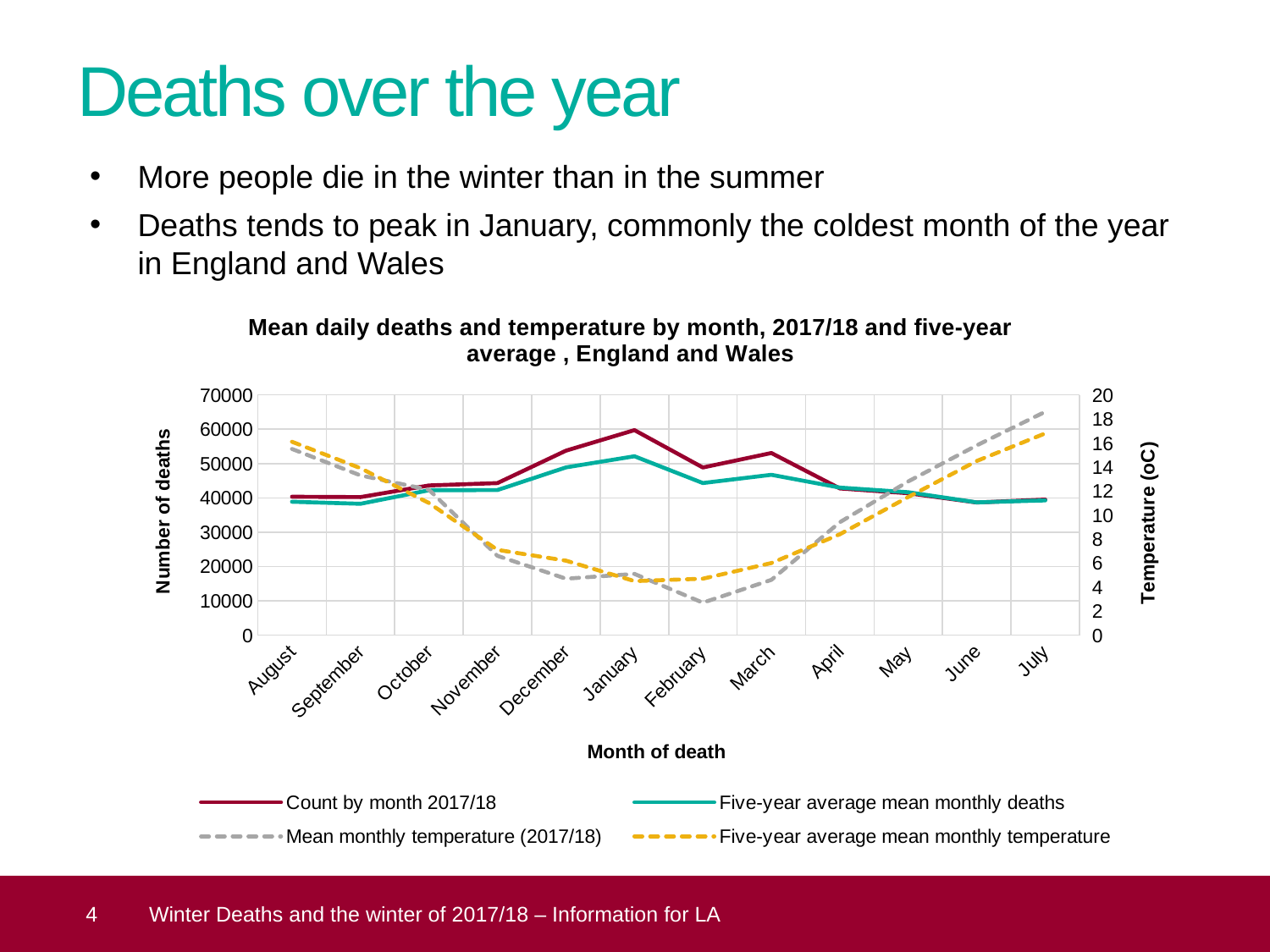
What kind of chart is shown on the slide? Line chart What is the label of the right-hand vertical axis? Temperature (oC) In which month does the Count by month 2017/18 series reach its highest value? January Is the value for Five-year average mean monthly temperature in July greater or less than 14? greater How many months are plotted along the x axis? 12 Is the value for Mean monthly temperature (2017/18) in February greater or less than 6? less In which month is the Mean monthly temperature (2017/18) series at its lowest? February In which month is the Mean monthly temperature (2017/18) series at its highest? July How many series does the chart legend list? 4 Does the Mean monthly temperature (2017/18) series rise or fall from August to February? Fall Is the value for Count by month 2017/18 in January greater or less than 50000? greater In January, which is higher: Count by month 2017/18 or Five-year average mean monthly deaths? Count by month 2017/18